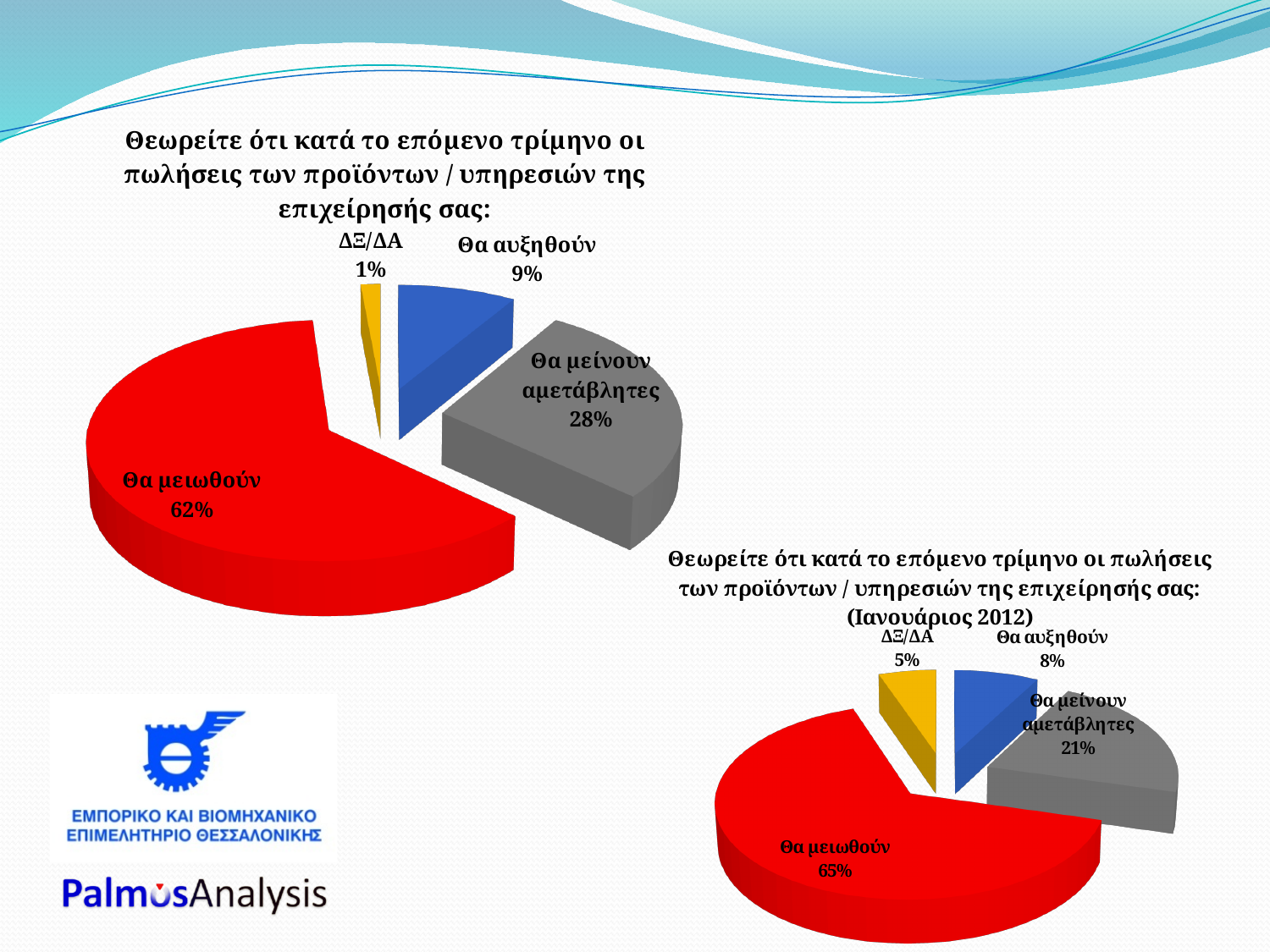
In the top-left pie chart, what percentage is shown for "Θα μείνουν αμετάβλητες"? 28% How many slices does the top-left pie chart have? 4 What type of chart is used on this slide? Pie chart Which chart shows a larger share for "Θα μειωθούν": the top-left chart or the bottom-right chart (Ιανουάριος 2012)? The bottom-right chart (Ιανουάριος 2012) In the top-left pie chart, what percentage is shown for "ΔΞ/ΔΑ"? 1% In the bottom-right pie chart (Ιανουάριος 2012), what percentage is shown for "Θα αυξηθούν"? 8% In the bottom-right pie chart (Ιανουάριος 2012), what share is shown for "Θα μειωθούν"? 65% In the bottom-right pie chart (Ιανουάριος 2012), which category has the smallest slice? ΔΞ/ΔΑ In the bottom-right pie chart (Ιανουάριος 2012), what percentage is shown for "ΔΞ/ΔΑ"? 5% In the top-left pie chart, what is the difference in percentage points between "Θα μείνουν αμετάβλητες" and "Θα αυξηθούν"? 19 percentage points In the top-left pie chart, what share of respondents answered "Θα μειωθούν"? 62% In the top-left pie chart, which category has the largest slice? Θα μειωθούν